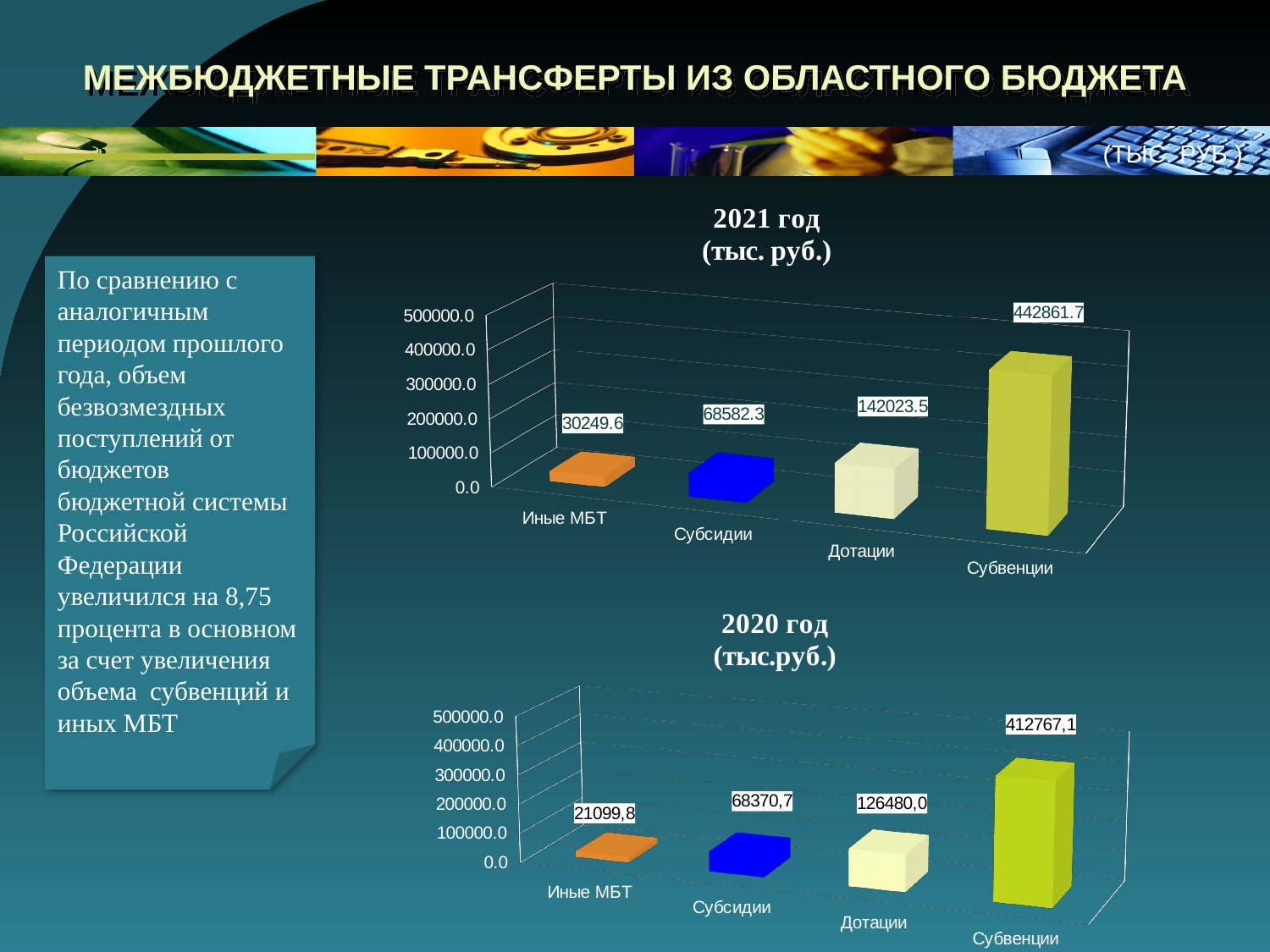
In the 2020 год chart, which category has the lowest value? Иные МБТ In the 2020 год chart, what is the difference between Дотации and Субсидии? 58109,3 In the 2020 год chart, what is the value for Дотации? 126480,0 In the 2020 год chart, what is the value for Субсидии? 68370,7 In the 2021 год chart, what is the value for Субвенции? 442861.7 In the 2021 год chart, what is the value for Иные МБТ? 30249.6 How many categories are shown in the 2020 год chart? 4 In the 2021 год chart, do the values rise or fall from left to right along the x axis? rise What kind of chart is the 2021 год chart? bar chart In the 2021 год chart, which category has the highest value? Субвенции In the 2021 год chart, what is the difference between Субвенции and Дотации? 300838.2 In the 2021 год chart, which is larger, Субсидии or Дотации? Дотации